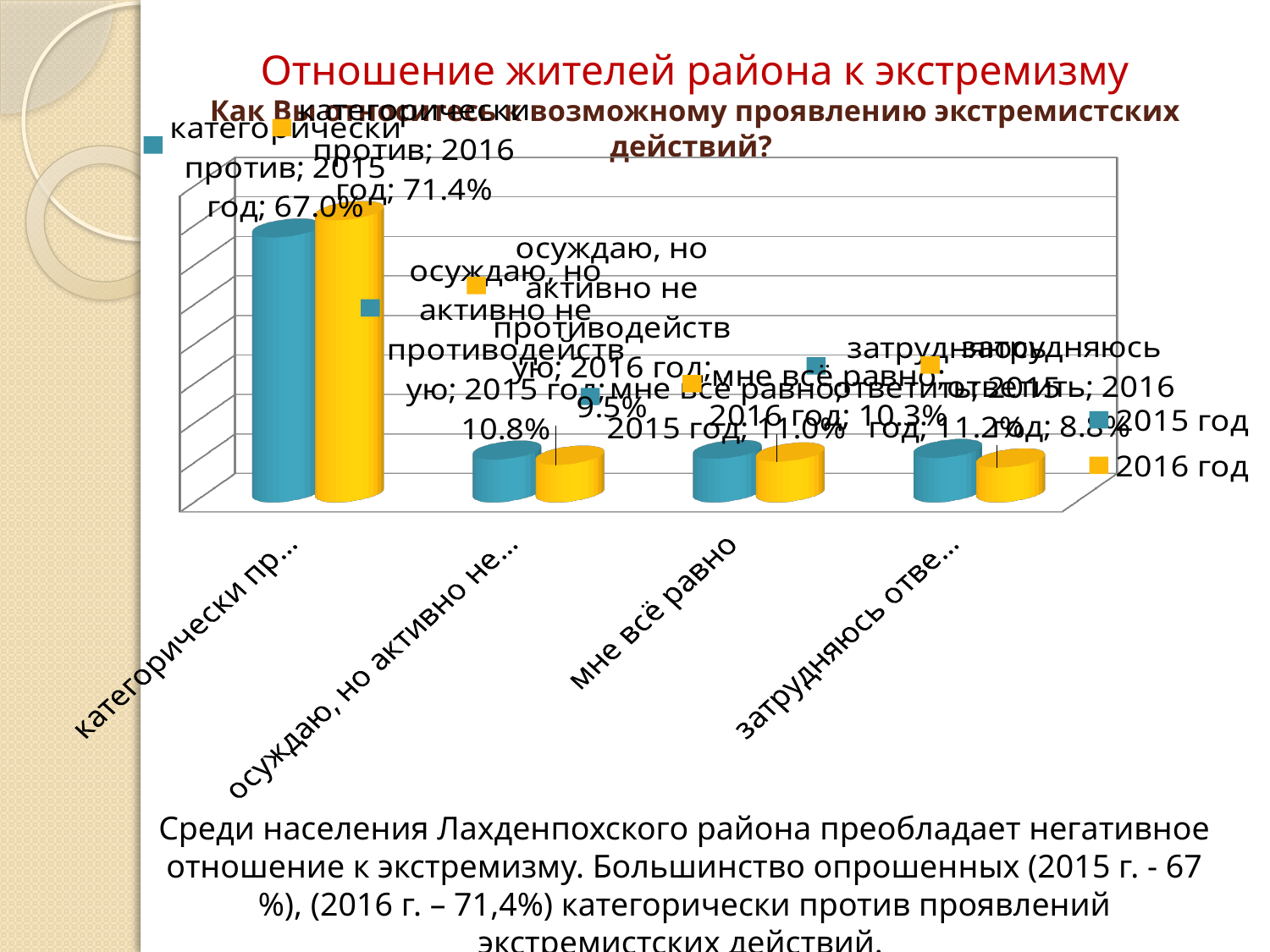
What is the value for 'затрудняюсь ответить' in 2015? 11.2% Which category has the lowest value in the 2016 series? затрудняюсь ответить For 'осуждаю, но активно не противодействую', which year has the larger value, 2015 or 2016? 2015 Which category has the highest value in the 2016 series? категорически против What are the two series named in the legend? 2015 год and 2016 год What is the value for 'категорически против' in 2015? 67.0% What is the difference between the 2016 and 2015 values for 'категорически против'? 4.4% How many series does the legend list? 2 What is the value for 'мне всё равно' in 2016? 10.3% What is the value for 'категорически против' in 2016? 71.4% What kind of chart is shown on the slide? bar chart How many response categories are shown on the x axis? 4